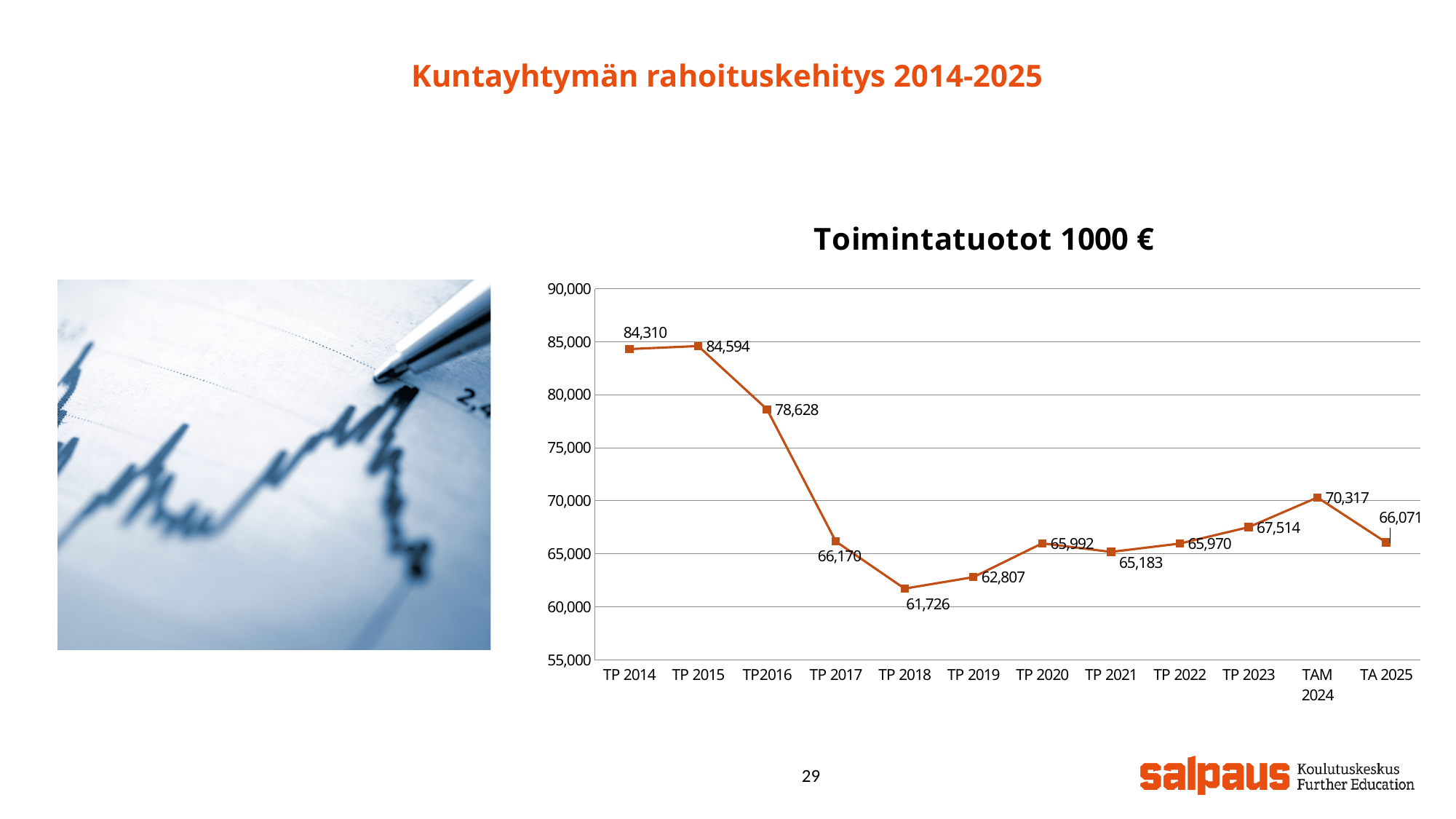
What is the value for TP 2014 in the Toimintatuotot 1000 € chart? 84,310 What is the value for TAM 2024 in the Toimintatuotot 1000 € chart? 70,317 Which category has the lowest value in the Toimintatuotot 1000 € chart? TP 2018 Which is larger in the Toimintatuotot 1000 € chart, the value for TP 2020 or the value for TP 2021? TP 2020 Which category has the highest value in the Toimintatuotot 1000 € chart? TP 2015 Is the value for TP 2017 in the Toimintatuotot 1000 € chart greater or less than 70,000? less Do the values in the Toimintatuotot 1000 € chart rise or fall from TP 2015 to TP 2018? fall What is the difference between the values for TP 2015 and TP2016 in the Toimintatuotot 1000 € chart? 5,966 How many data points are plotted in the Toimintatuotot 1000 € chart? 12 What kind of chart is the Toimintatuotot 1000 € chart? line chart What is the value for TP 2018 in the Toimintatuotot 1000 € chart? 61,726 What is the value for TA 2025 in the Toimintatuotot 1000 € chart? 66,071